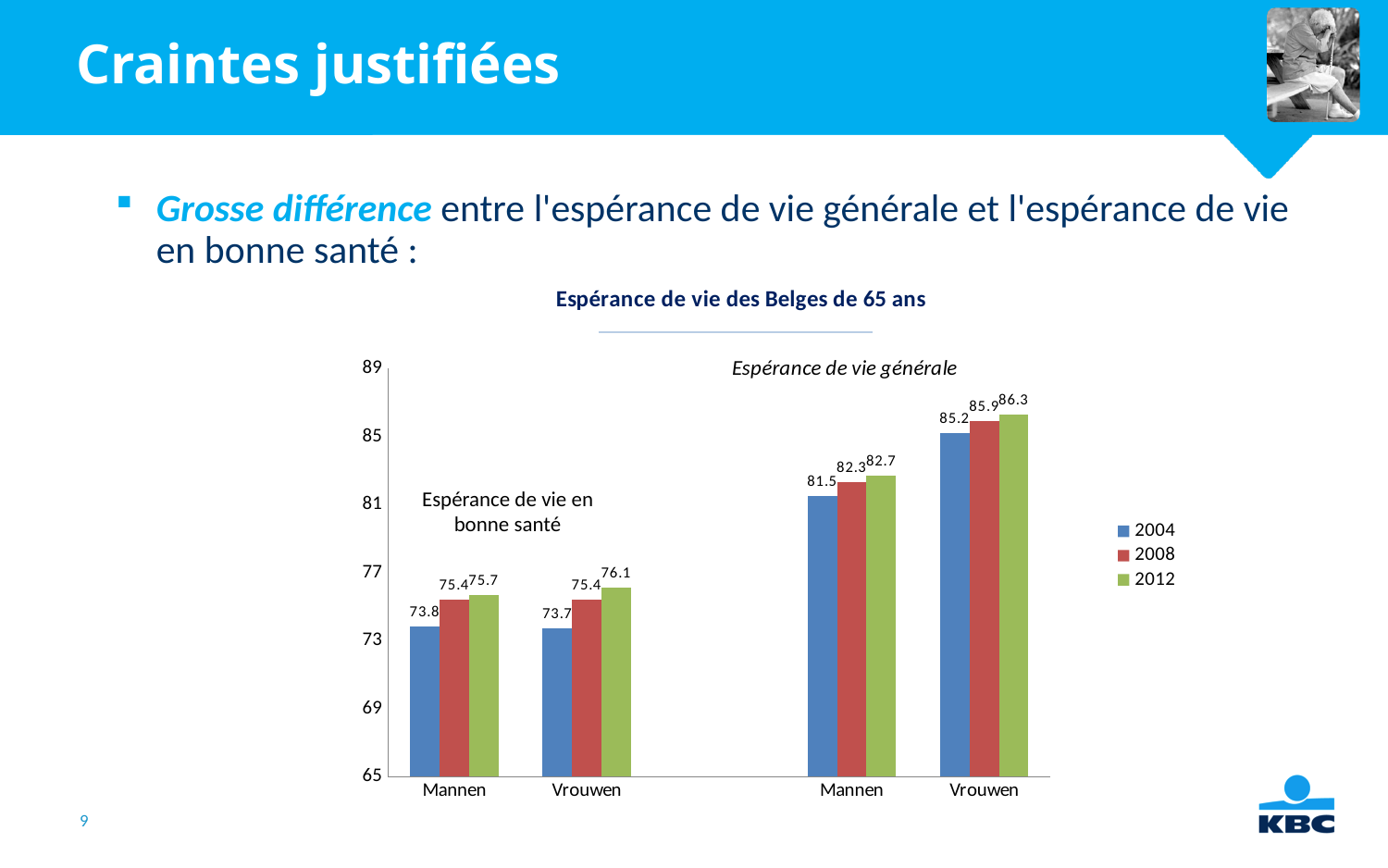
What is the 2004 value for Mannen under Espérance de vie en bonne santé? 73.8 How many series does the legend list? 3 What is the 2012 value for Vrouwen under Espérance de vie en bonne santé? 76.1 What is the title of the chart? Espérance de vie des Belges de 65 ans What is the 2008 value for Mannen under Espérance de vie générale? 82.3 Which is larger: the 2004 value for Vrouwen under Espérance de vie générale or the 2012 value for Mannen under Espérance de vie générale? Vrouwen 2004 (85.2) What is the difference between the 2012 values for Vrouwen under Espérance de vie générale and under Espérance de vie en bonne santé? 10.2 Which bar has the lowest value in the chart? Vrouwen, 2004 (Espérance de vie en bonne santé) What kind of chart is shown on the slide? Bar chart What is the 2012 value for Vrouwen under Espérance de vie générale? 86.3 What is the difference between the 2004 and 2012 values for Mannen under Espérance de vie générale? 1.2 Which bar has the highest value in the chart? Vrouwen, 2012 (Espérance de vie générale)